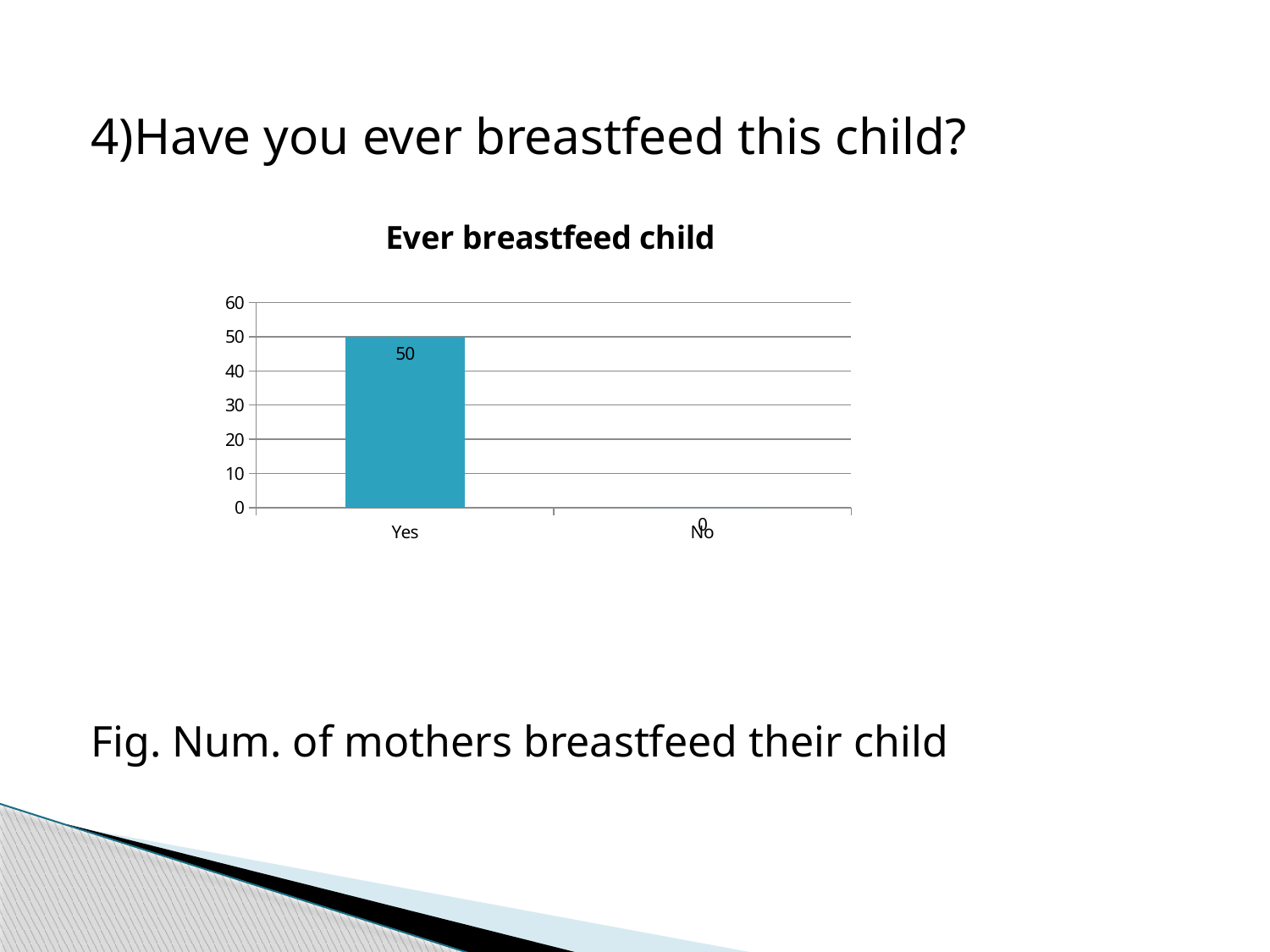
What is the title of the chart? Ever breastfeed child Which is larger, the value for Yes or the value for No? Yes Is the value for Yes greater or less than 40? greater What is the highest value shown on the y axis? 60 What is the value for No? 0 What is the value for Yes? 50 What is the difference between the values for Yes and No? 50 Which category has the lowest value? No What kind of chart is shown on the slide? bar chart Which category has the highest value? Yes How many categories are shown on the x axis? 2